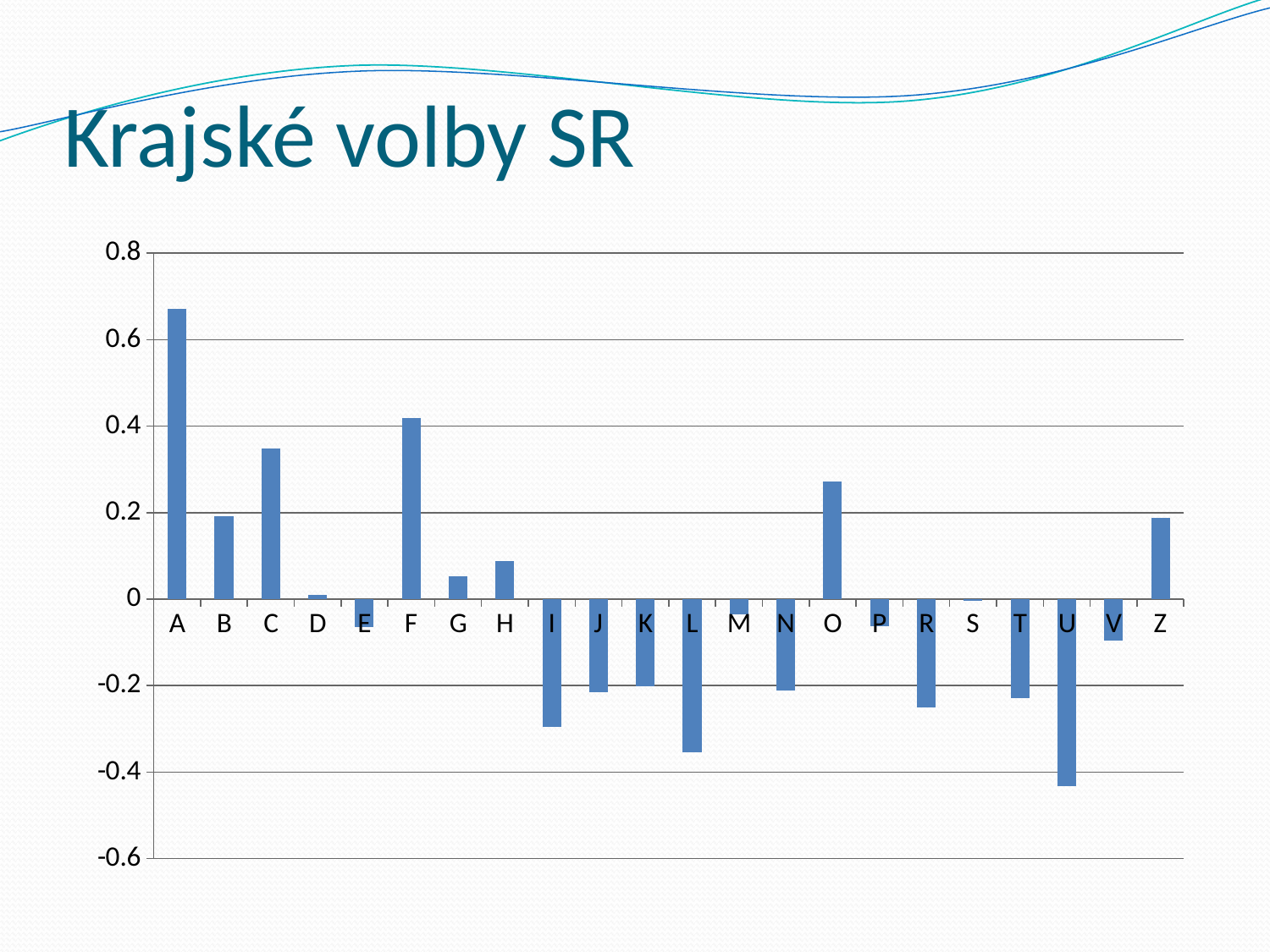
Is the value for U greater or less than -0.4? less Is the value for F greater or less than 0.4? greater Is the value for L greater or less than -0.2? less Which category has the highest value in the chart? A What is the title of the slide containing the chart? Krajské volby SR How many categories are plotted on the x axis of the chart? 22 Which has the larger value, O or Z? O What kind of chart is shown on the slide? bar chart Which has the larger value, C or B? C Which category has the lowest value in the chart? U